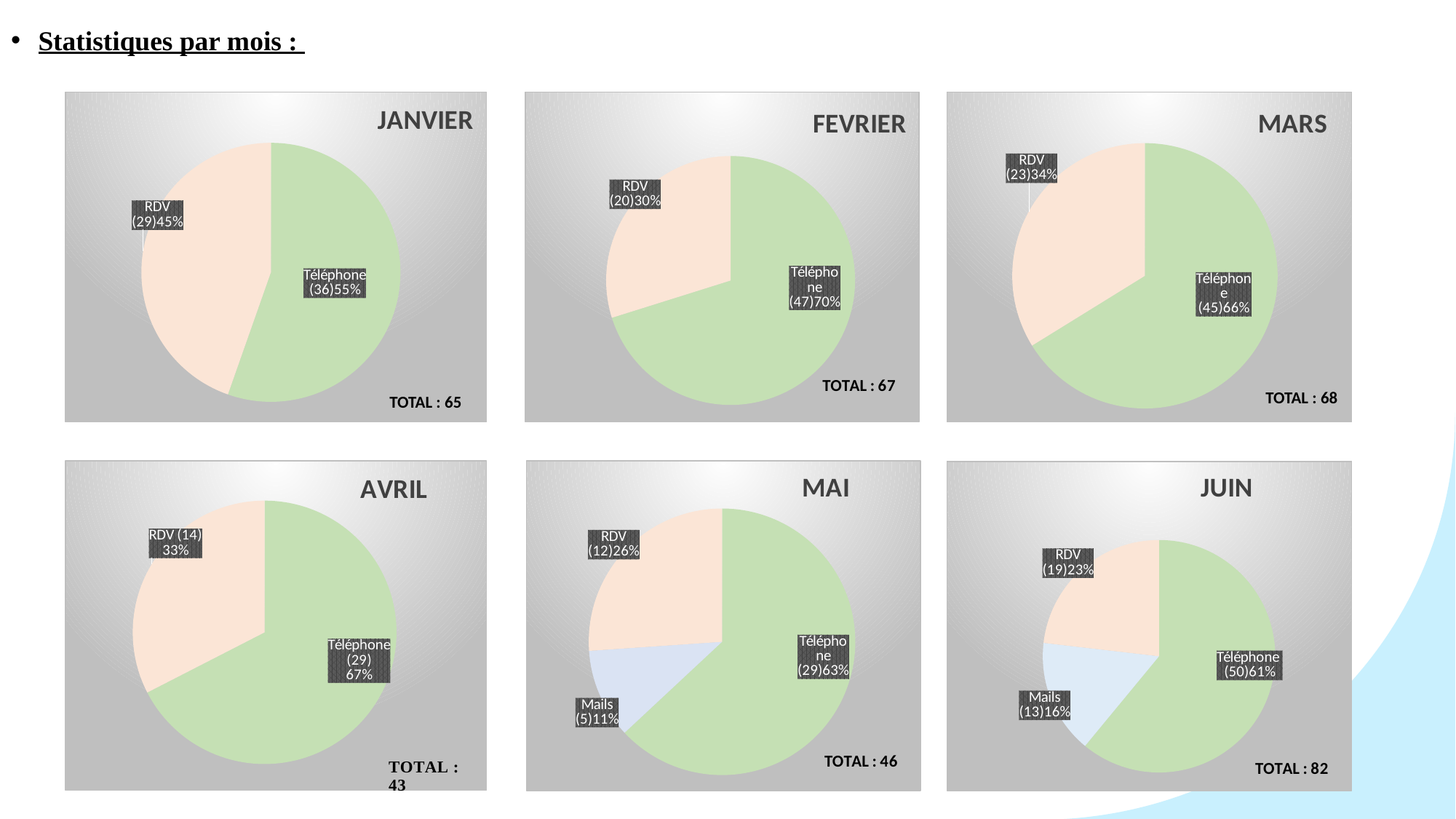
In the JUIN chart, which is larger, RDV or Mails? RDV In the AVRIL chart, which category is the largest? Téléphone In the JANVIER chart, what share of the pie does Téléphone represent? 55% In the FEVRIER chart, what is the value for Téléphone? 47 In the MAI chart, which category is the smallest? Mails What type of chart is used for each month on this slide? Pie chart In the MARS chart, what is the difference between the Téléphone count and the RDV count? 22 In the JUIN chart, what share of the pie does Mails represent? 16% What is the total shown on the JUIN chart? 82 In the JANVIER chart, how many RDV are shown? 29 In the MAI chart, how many categories are shown? 3 In the FEVRIER chart, what share of the pie does RDV represent? 30%